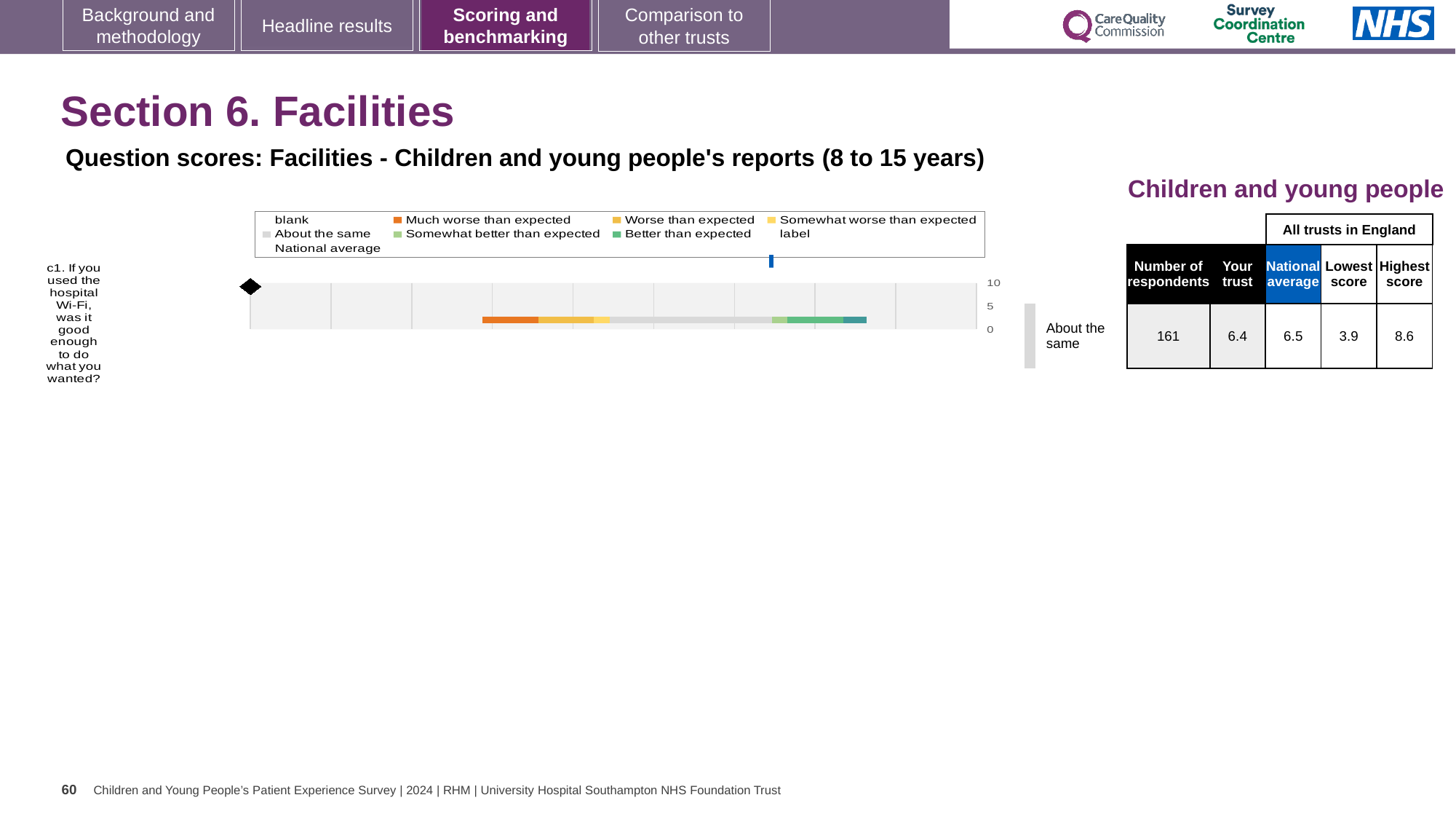
What is the highest tick value shown on the chart's score axis? 10 What is the highest score among all trusts in England for question c1? 8.6 What kind of chart is used to show the question score for c1? bar chart What is the label of the question plotted in the chart? c1. If you used the hospital Wi-Fi, was it good enough to do what you wanted? What is the lowest score among all trusts in England for question c1? 3.9 What is the 'Your trust' score for question c1? 6.4 How many survey questions are plotted in the chart? 1 Which benchmark category is the trust's result for question c1 placed in? About the same What is the national average score for question c1? 6.5 What is the difference between the highest score and the lowest score for question c1? 4.7 Which is larger for question c1: the 'Your trust' score or the national average? National average How many respondents answered question c1? 161